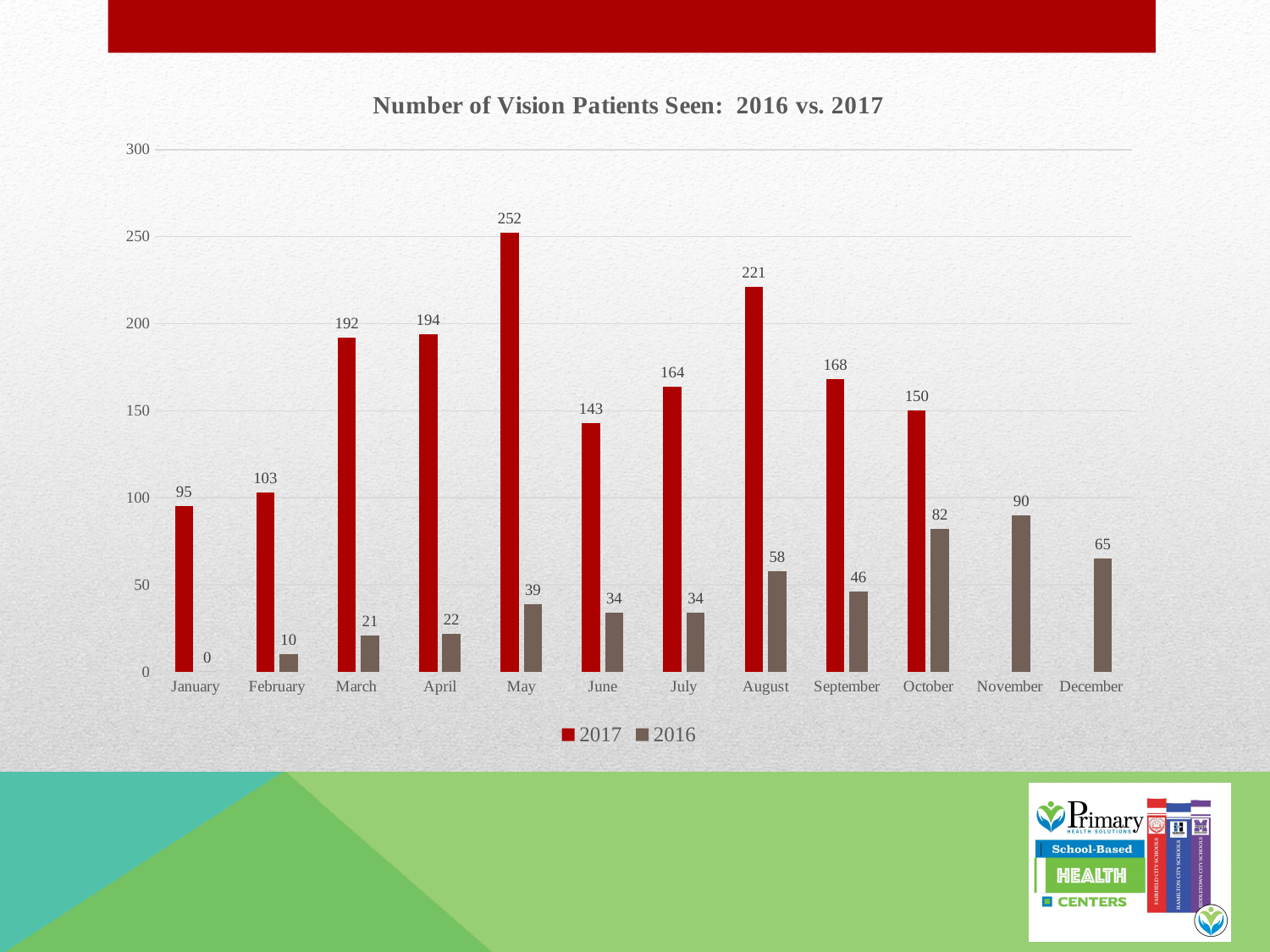
Is the 2017 value for September greater or less than 150? greater How many series does the legend list? 2 What kind of chart is shown on the slide? bar chart Which month has the lowest value for the 2016 series? January How many months are shown on the x axis? 12 What is the difference between the 2017 and 2016 values for August? 163 What is the title of the chart? Number of Vision Patients Seen: 2016 vs. 2017 Which is larger, the 2017 value for March or the 2017 value for April? April What is the number of vision patients seen in October 2016? 82 Which month has the highest value for the 2017 series? May Which colour represents the 2017 series in the legend? red What is the number of vision patients seen in May 2017? 252